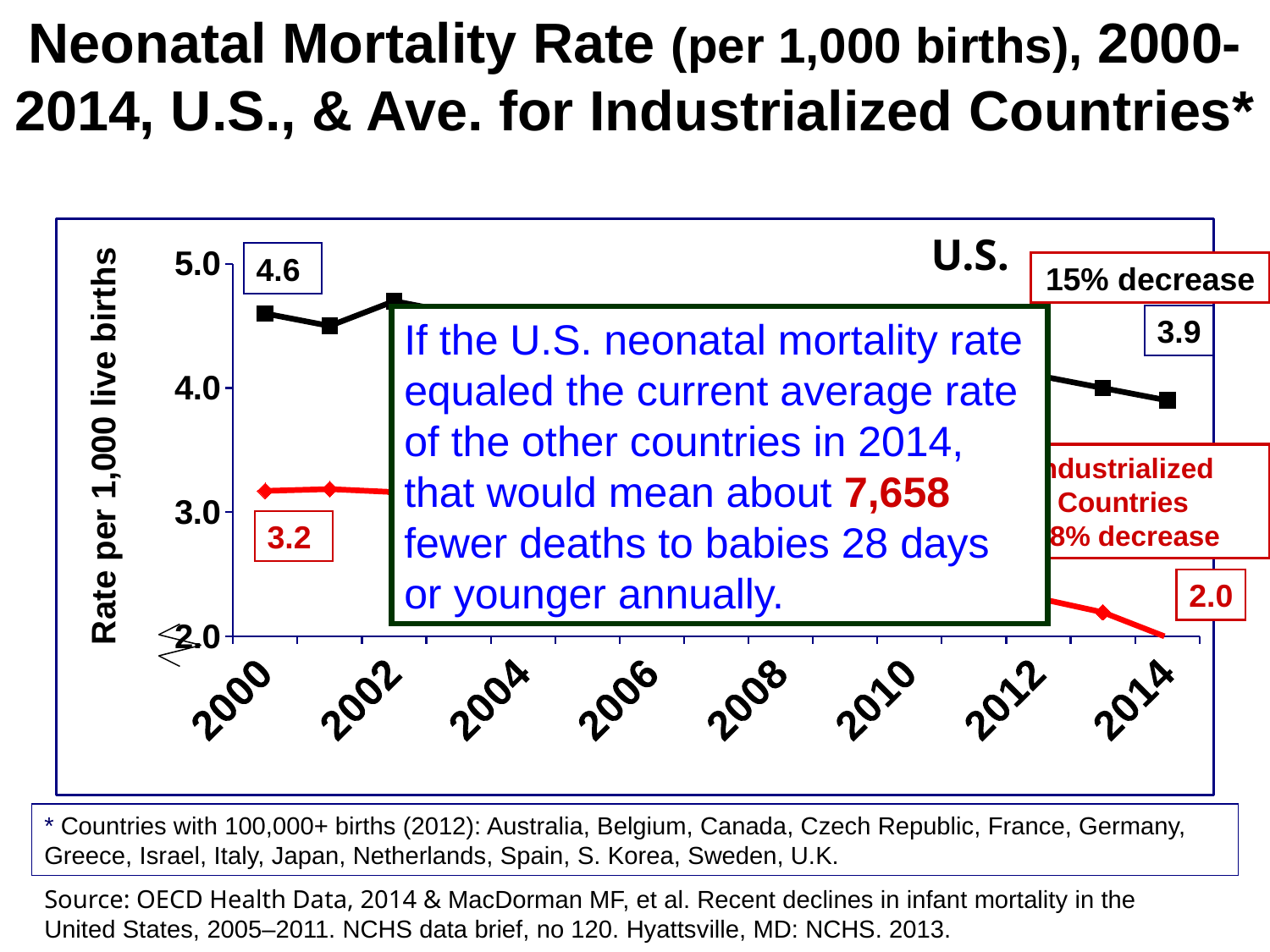
Is the U.S. neonatal mortality rate in 2002 greater or less than 4.0? greater What was the average neonatal mortality rate for industrialized countries in 2014? 2.0 What kind of chart is shown on the slide? line chart What was the U.S. neonatal mortality rate in 2000? 4.6 By how much did the U.S. neonatal mortality rate fall between 2000 and 2014? 0.7 What is the difference between the U.S. rate and the industrialized countries' average rate in 2014? 1.9 What percentage decrease is shown for the U.S. line? 15% decrease What was the U.S. neonatal mortality rate in 2014? 3.9 What was the average neonatal mortality rate for industrialized countries in 2000? 3.2 Which had the higher neonatal mortality rate in 2014, the U.S. or the average for industrialized countries? U.S. Does the U.S. neonatal mortality rate rise or fall from 2000 to 2014? fall By how much did the industrialized countries' average neonatal mortality rate fall between 2000 and 2014? 1.2